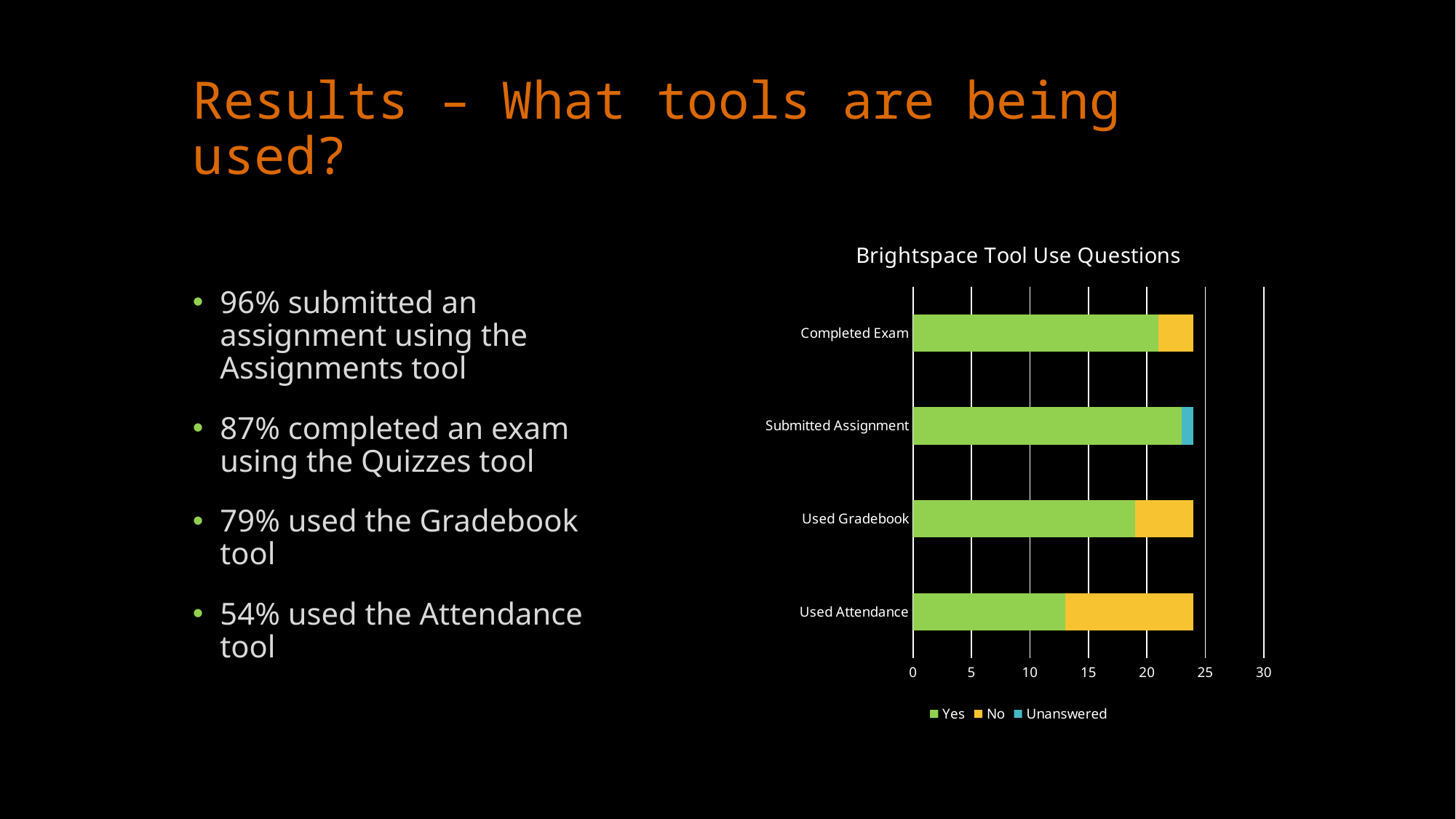
Which category has the smallest Yes value? Used Attendance Is the Yes value for Used Gradebook greater or less than 15? greater Is the Yes value for Used Attendance greater or less than 15? less Which has the larger No value, Used Attendance or Used Gradebook? Used Attendance Which category is the only one with an Unanswered segment? Submitted Assignment How many categories are shown on the chart's vertical axis? 4 Which category has the largest Yes value? Submitted Assignment What kind of chart is shown on the slide? Stacked bar chart What is the title of the chart? Brightspace Tool Use Questions Which has the larger Yes value, Completed Exam or Used Attendance? Completed Exam Is the Yes value for Completed Exam greater or less than 20? greater How many series does the chart's legend list? 3